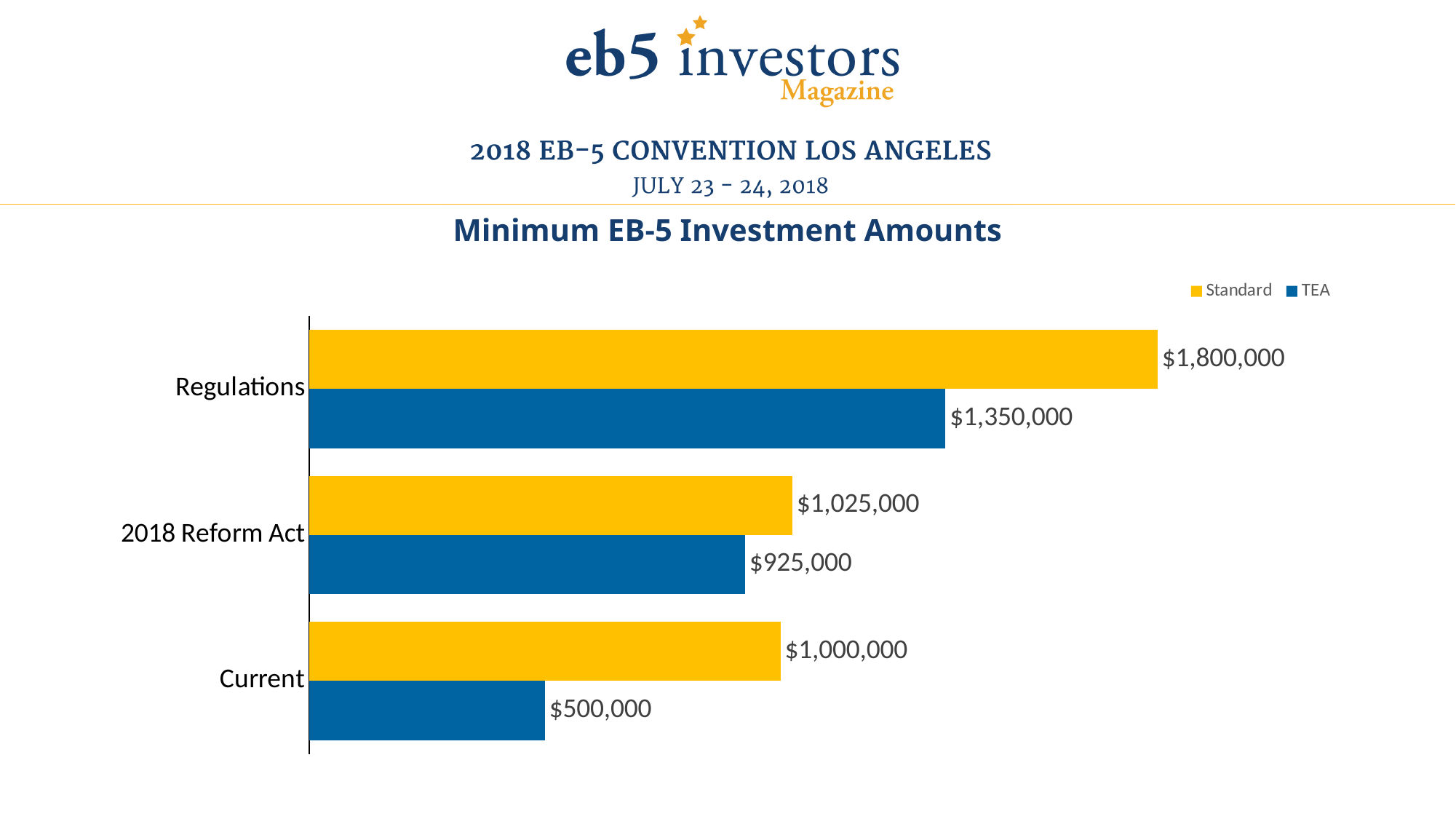
Which is larger, the Standard amount under the 2018 Reform Act or the Current Standard amount? 2018 Reform Act What kind of chart is shown on the slide? Bar chart What is the TEA minimum investment amount under the 2018 Reform Act? $925,000 How many series does the legend list? 2 What is the Current Standard minimum investment amount? $1,000,000 What is the Standard minimum investment amount under Regulations? $1,800,000 How many categories are shown on the chart? 3 Which category has the lowest TEA minimum investment amount? Current What is the difference between the Current Standard amount and the Current TEA amount? $500,000 Which category has the highest Standard minimum investment amount? Regulations What is the Current TEA minimum investment amount? $500,000 What is the difference between the Standard and TEA amounts under Regulations? $450,000